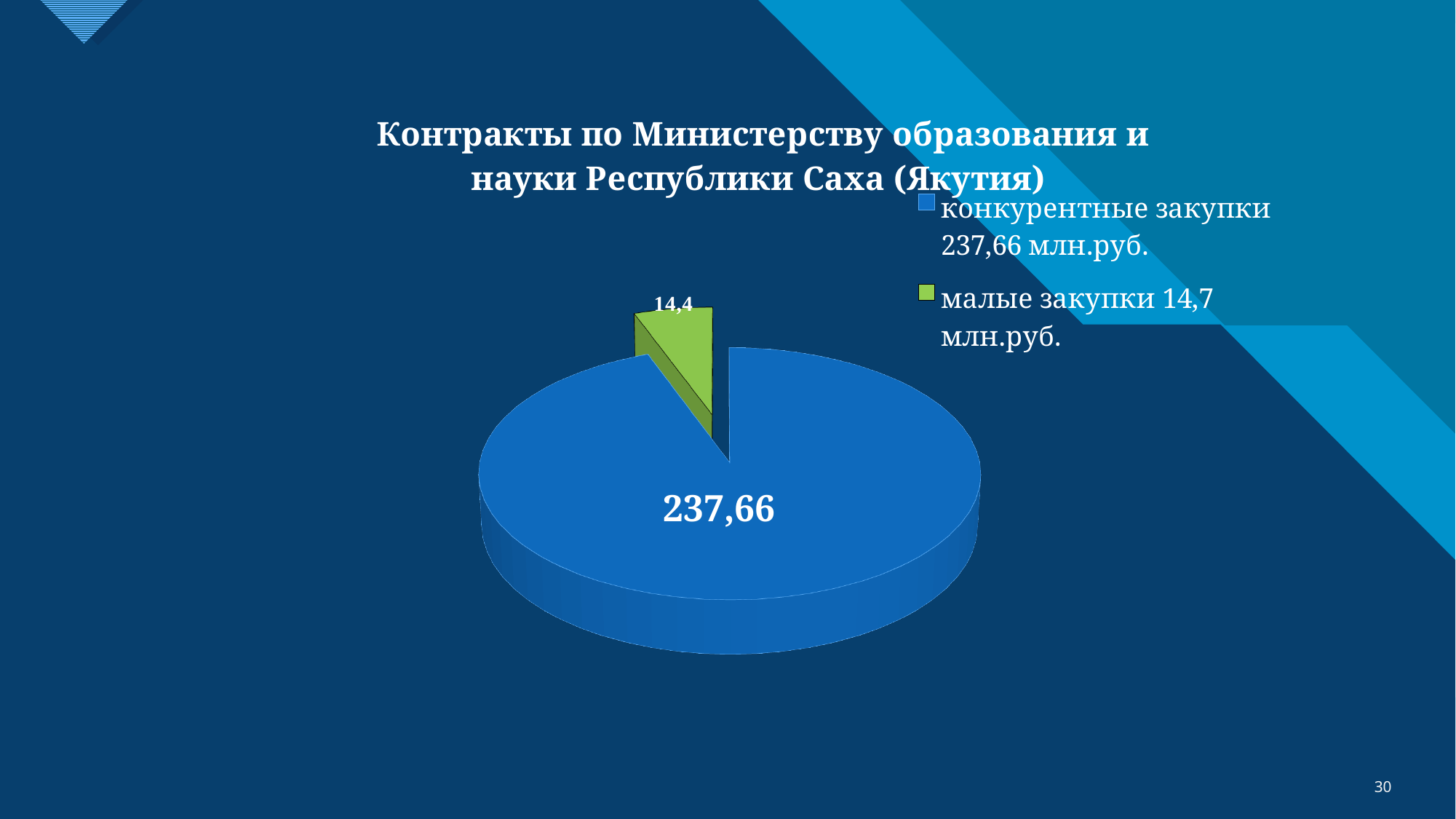
What colour is the slice for малые закупки? green Which is larger, конкурентные закупки or малые закупки? конкурентные закупки Which category has the largest slice in the pie chart? конкурентные закупки What type of chart is shown on the slide? pie chart Which category has the smallest slice in the pie chart? малые закупки What is the title of the chart? Контракты по Министерству образования и науки Республики Саха (Якутия) How many slices does the pie chart have? 2 What value is printed on the large blue slice of the pie chart? 237,66 Is the value for конкурентные закупки greater or less than 200? greater Is the value for малые закупки greater or less than 50? less How many entries does the legend list? 2 What data label is printed next to the small green slice of the pie chart? 14,4